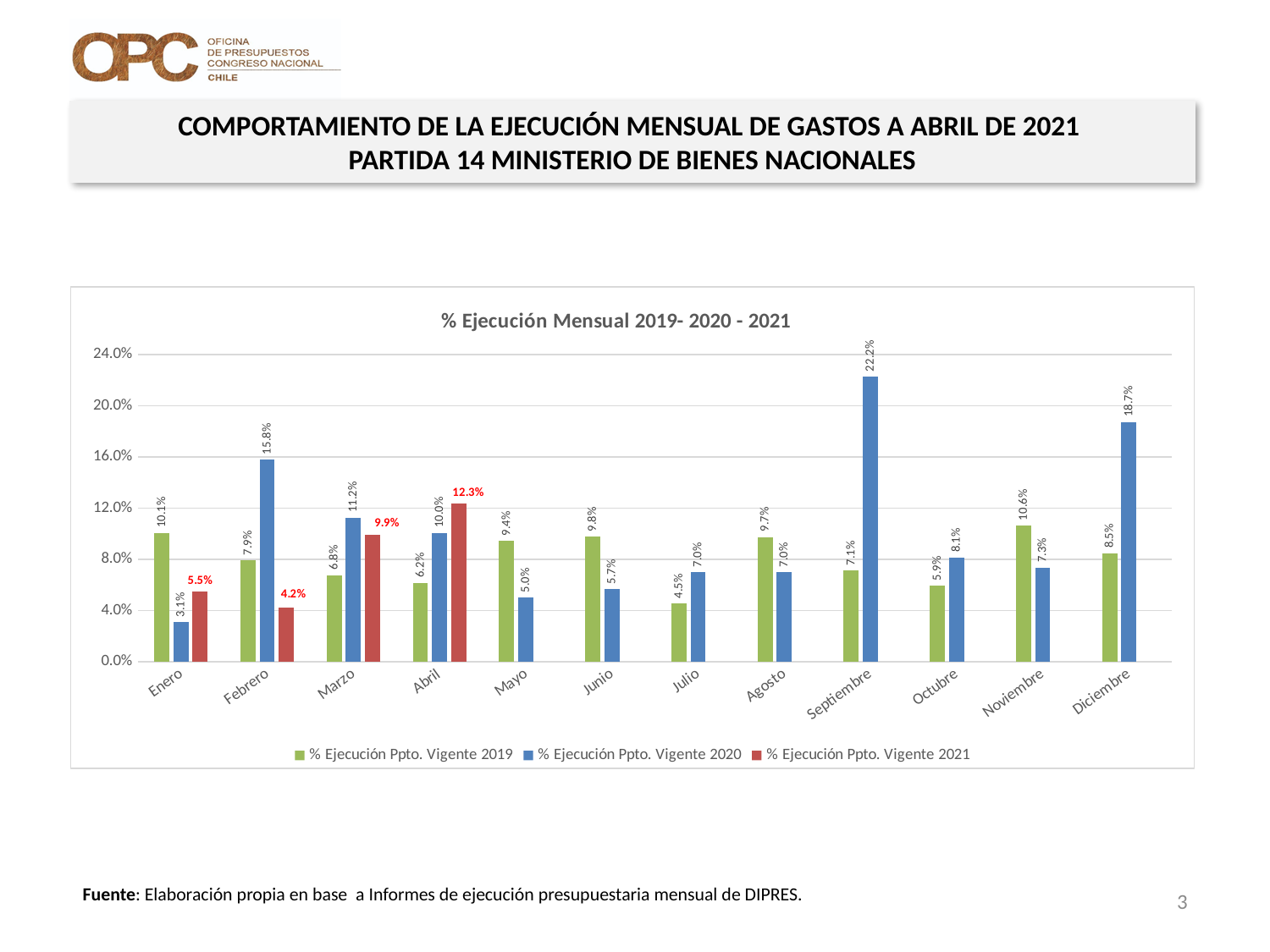
Which month has the highest value for % Ejecución Ppto. Vigente 2020? Septiembre Which is larger in Marzo: the 2020 value or the 2021 value? 2020 value (11.2%) What is the value for % Ejecución Ppto. Vigente 2021 in Abril? 12.3% Which month has the lowest value for % Ejecución Ppto. Vigente 2019? Julio What is the value for % Ejecución Ppto. Vigente 2019 in Noviembre? 10.6% How many series does the legend list? 3 What is the value for % Ejecución Ppto. Vigente 2020 in Septiembre? 22.2% What is the difference between the 2020 and 2019 values in Febrero? 7.9% Is the value for % Ejecución Ppto. Vigente 2020 in Diciembre greater or less than 16.0%? greater How many months are shown on the x axis? 12 What kind of chart is shown on the slide? Bar chart What is the title of the chart? % Ejecución Mensual 2019- 2020 - 2021